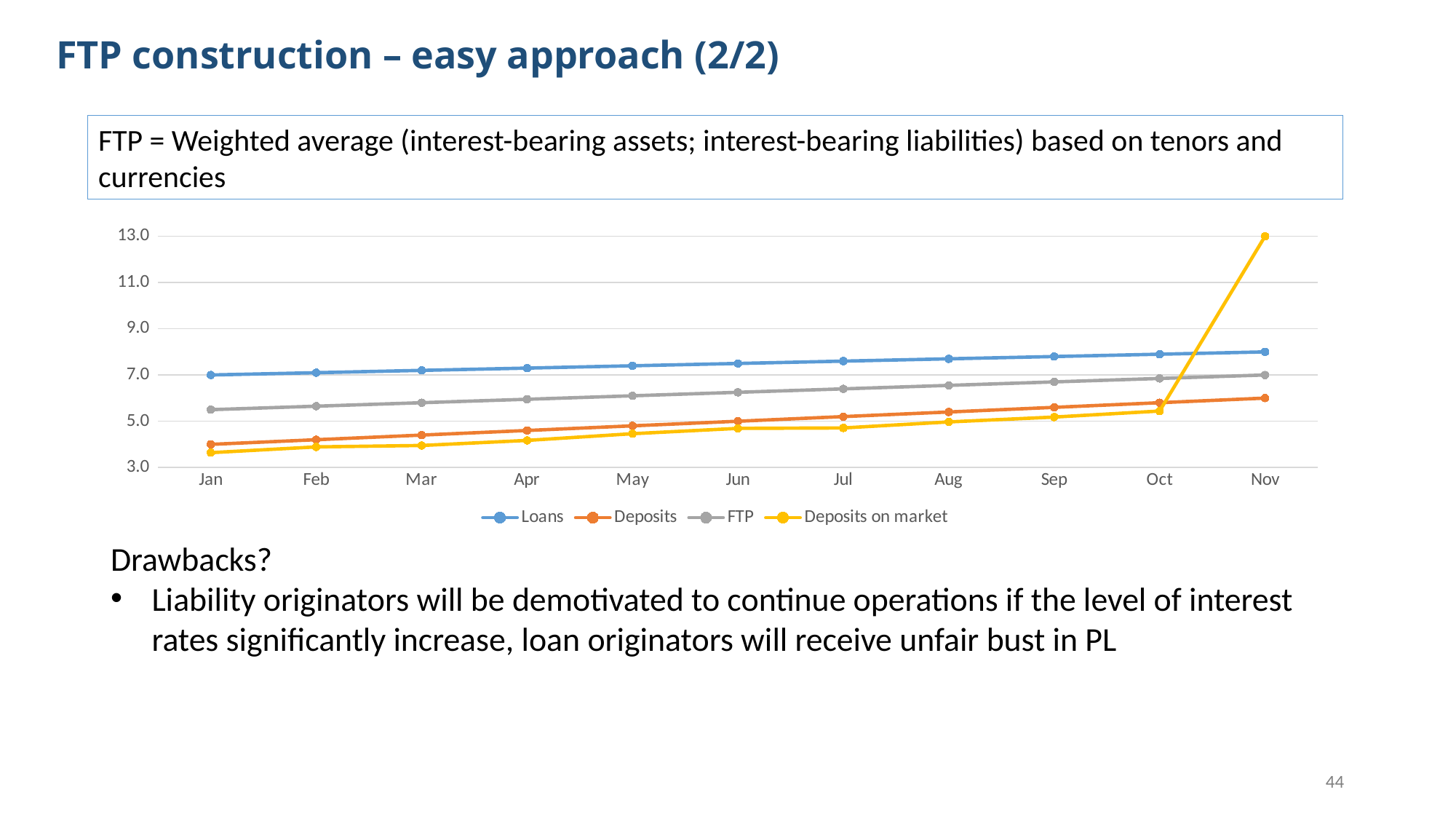
What is the value of the Loans series in Jan? 7.0 How many months are shown on the x axis of the chart? 11 Which series has the lowest value in Jan? Deposits on market What kind of chart is shown on the slide? line chart Which series has the highest value in Nov? Deposits on market How many series does the chart legend list? 4 Is the value for Loans in Jun greater or less than 7.0? greater What is the value of the Deposits on market series in Nov? 13.0 Is the value for Deposits in Jan greater or less than 5.0? less Which series in the legend is drawn in yellow? Deposits on market Does the Loans series rise or fall from Jan to Nov? rise Which is larger in Jan, Loans or FTP? Loans